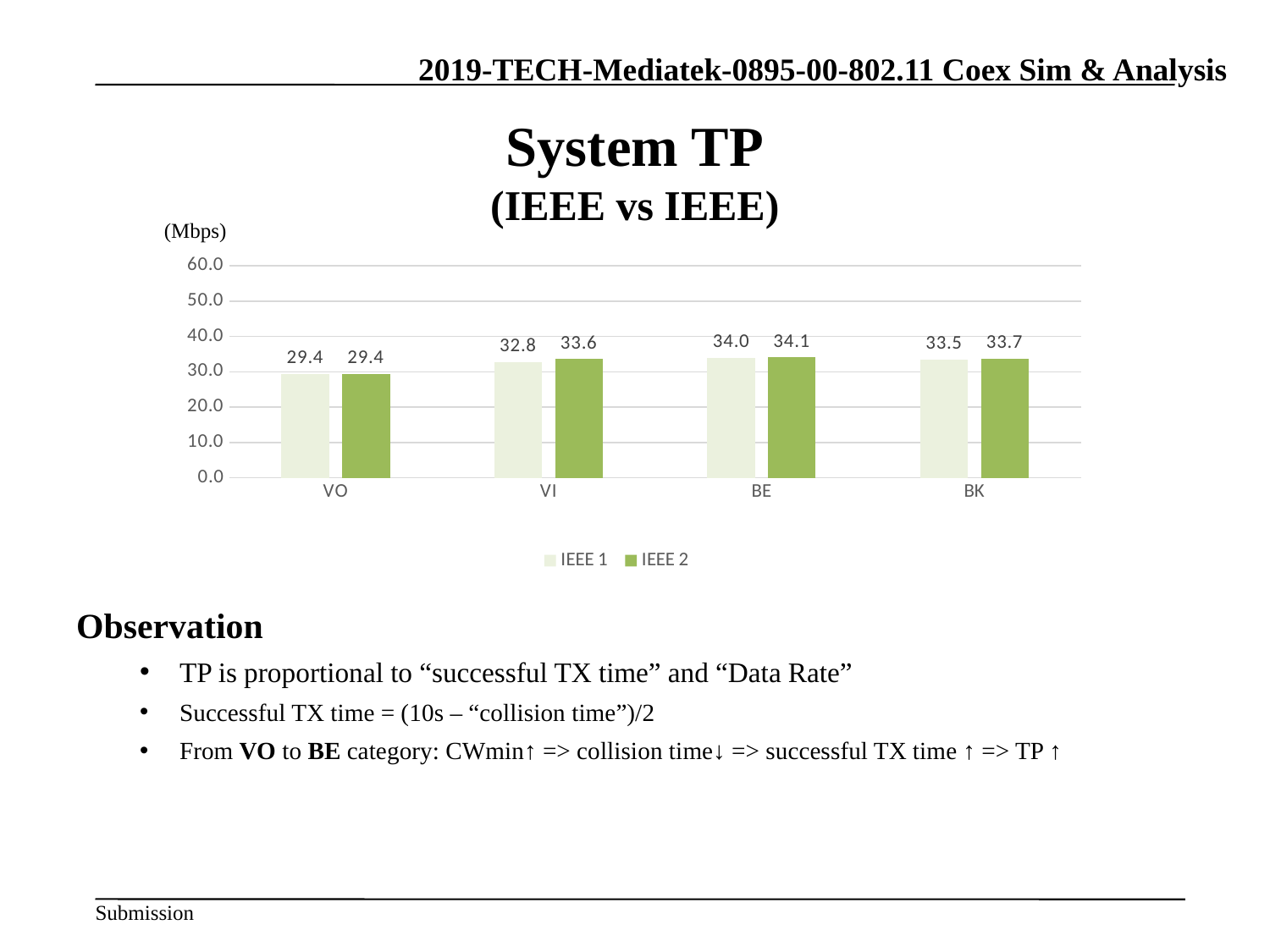
What is the value for IEEE 1 in the VO category? 29.4 What kind of chart is shown on the slide? bar chart Which is larger: the IEEE 1 value for VI or the IEEE 1 value for BK? BK How many series does the legend list? 2 What is the difference between the IEEE 1 values for BE and VO? 4.6 Is the value for IEEE 2 in the BE category greater or less than 30.0? greater Which category has the lowest value for IEEE 2? VO How many categories are shown on the x axis? 4 Which category has the highest value for IEEE 1? BE What is the value for IEEE 2 in the BK category? 33.7 What is the value for IEEE 2 in the VI category? 33.6 What is the difference between the IEEE 2 and IEEE 1 values in the VI category? 0.8